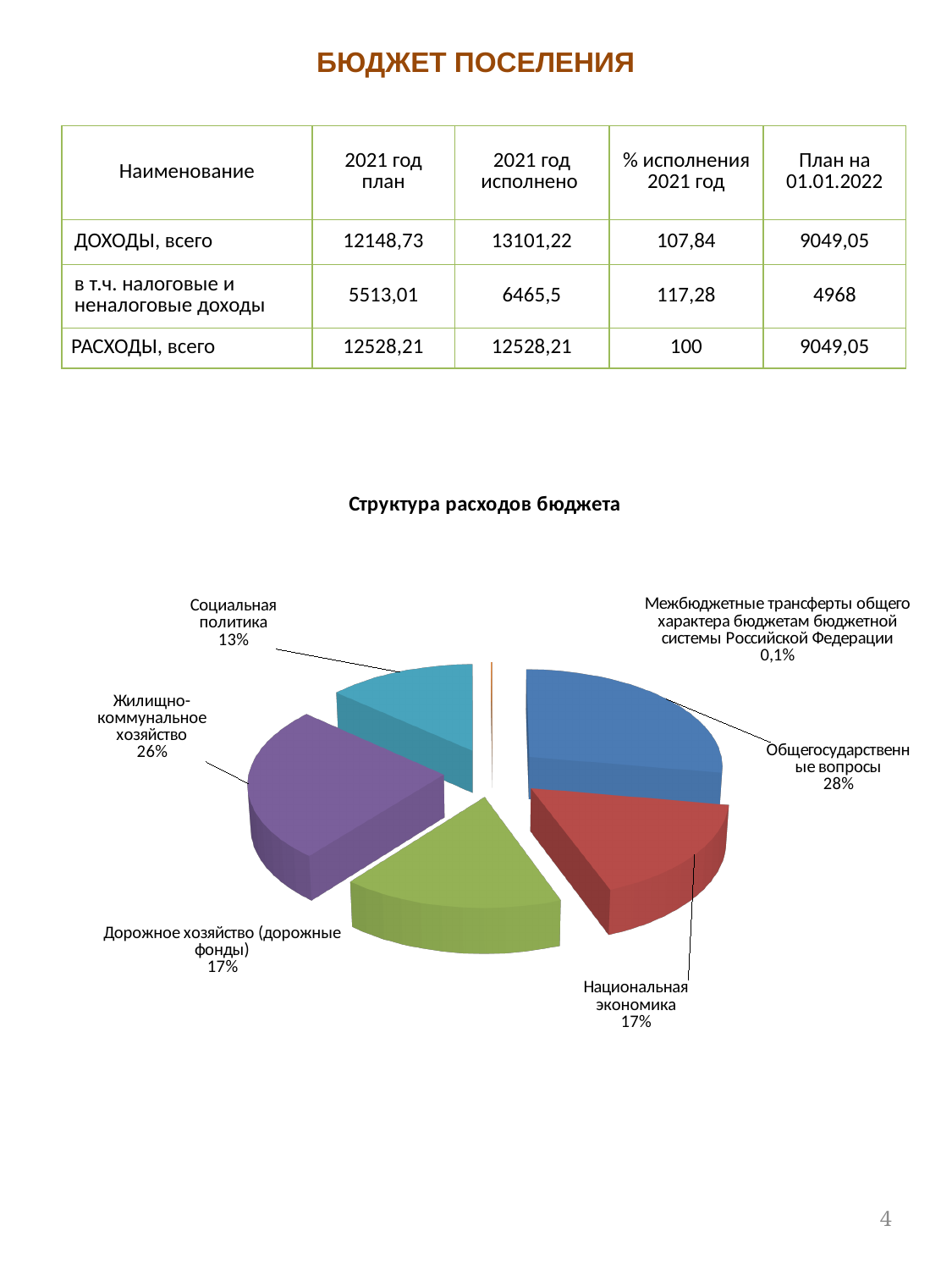
What is the title of the chart on the slide? Структура расходов бюджета What share of the pie chart is "Дорожное хозяйство (дорожные фонды)"? 17% Which slice is larger in the pie chart: "Жилищно-коммунальное хозяйство" or "Социальная политика"? Жилищно-коммунальное хозяйство What share of the pie chart is "Социальная политика"? 13% Which category has the largest slice in the pie chart? Общегосударственные вопросы How many slices does the pie chart have? 6 What kind of chart is shown under the title "Структура расходов бюджета"? Pie chart Which category has the smallest slice in the pie chart? Межбюджетные трансферты общего характера бюджетам бюджетной системы Российской Федерации What share of the pie chart is "Межбюджетные трансферты общего характера бюджетам бюджетной системы Российской Федерации"? 0,1% What is the difference in percentage points between "Общегосударственные вопросы" and "Жилищно-коммунальное хозяйство" in the pie chart? 2%